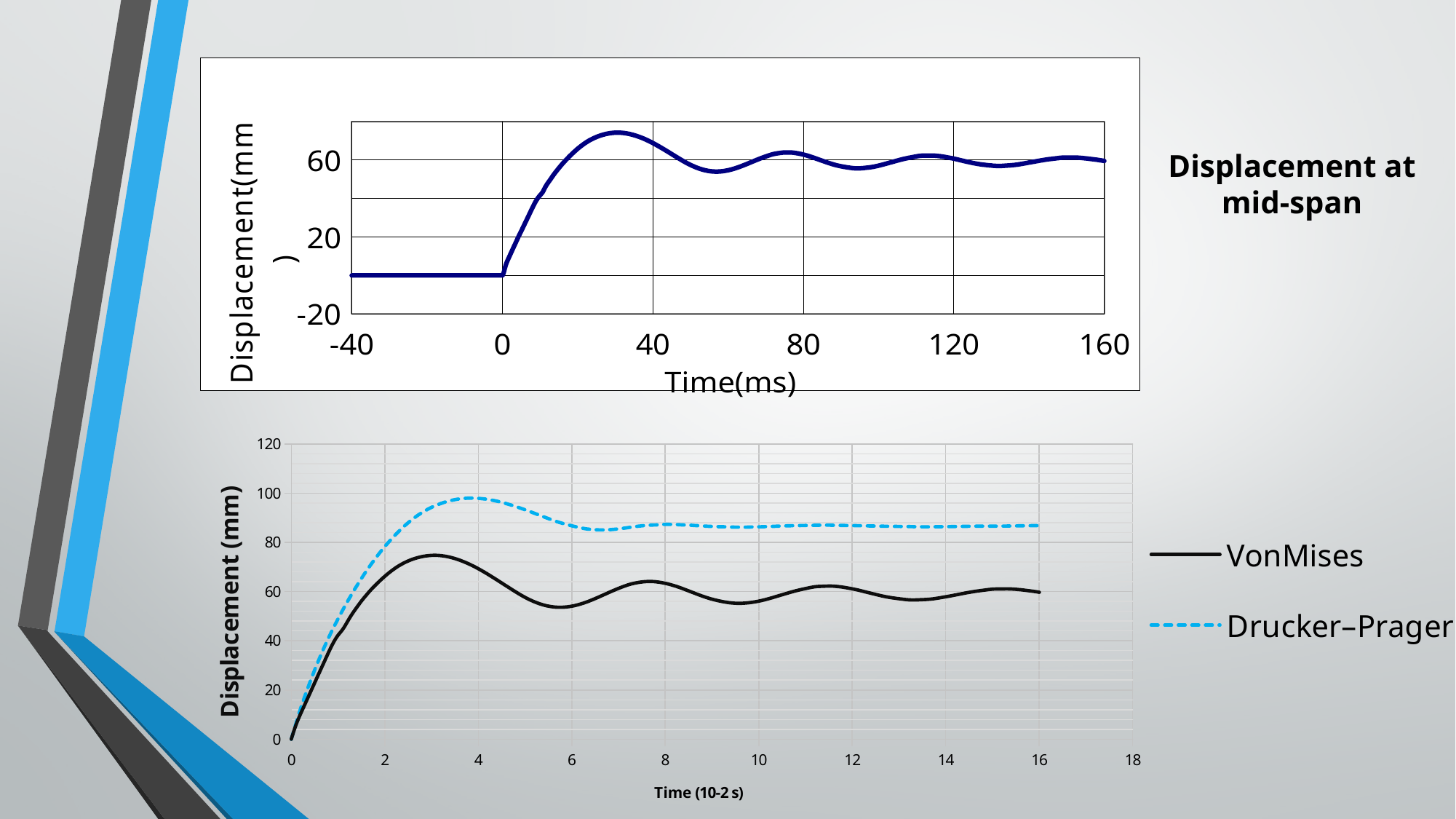
What kind of chart is the top chart titled 'Displacement at mid-span'? line chart In the bottom chart, is the peak value of the Drucker–Prager series greater or less than 80? greater What is the x-axis title of the top chart? Time(ms) What kind of chart is the bottom chart with the VonMises and Drucker–Prager series? line chart In the top chart, is the displacement at 160 ms greater or less than 20? greater In the bottom chart, which series has the higher displacement at time 4? Drucker–Prager In the top chart, what is the displacement value before time 0? 0 How many series does the legend of the bottom chart list? 2 In the top chart, is the peak displacement greater or less than 60? greater In the bottom chart, which series is drawn with a dashed line? Drucker–Prager